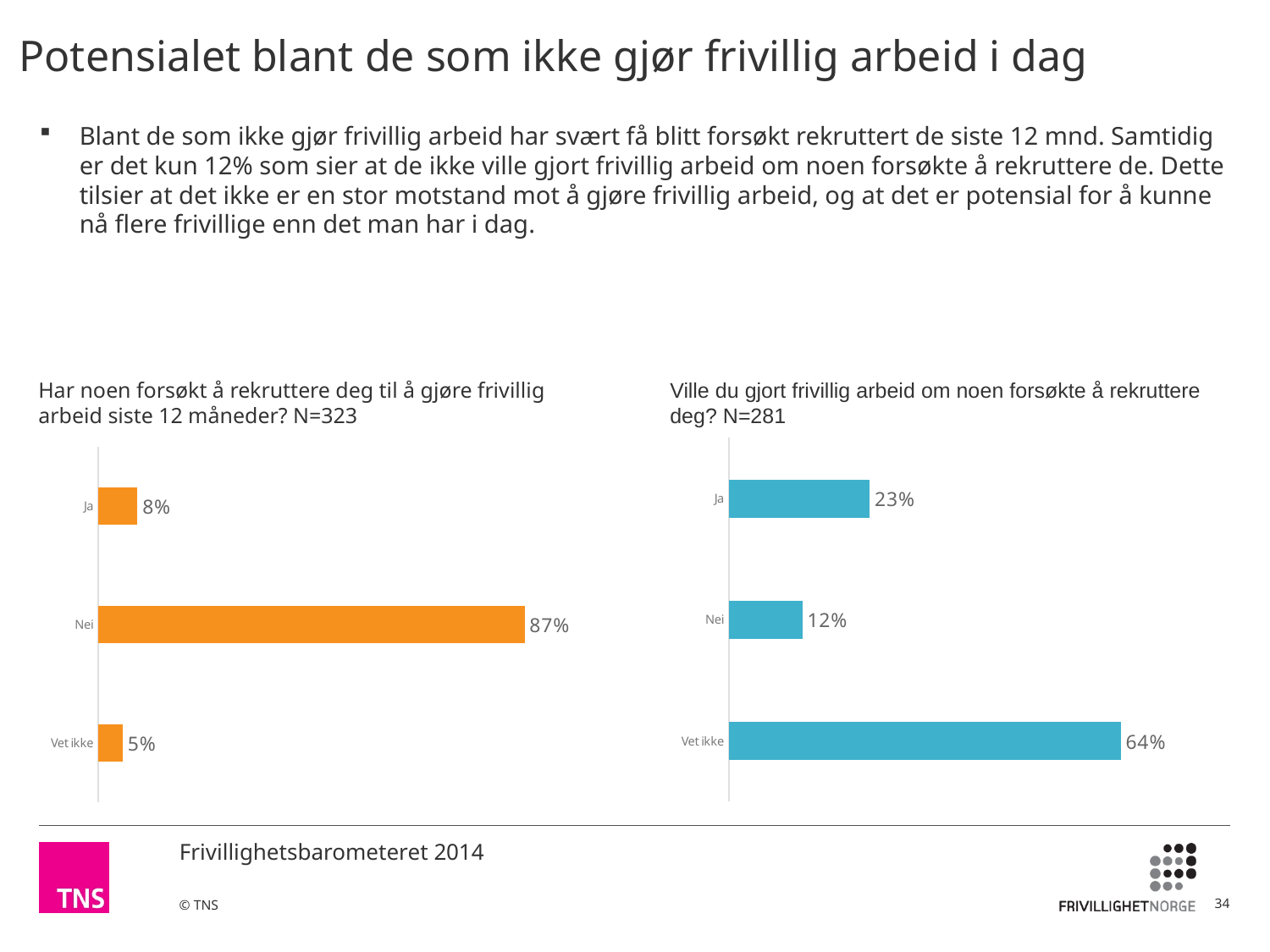
In the left chart (Har noen forsøkt å rekruttere deg...), what is the value for Nei? 87% In the right chart (Ville du gjort frivillig arbeid...), what is the value for Vet ikke? 64% How many categories does the left chart (Har noen forsøkt å rekruttere deg...) show? 3 In the right chart (Ville du gjort frivillig arbeid...), what is the value for Nei? 12% In the left chart (Har noen forsøkt å rekruttere deg...), which category has the highest value? Nei In the left chart (Har noen forsøkt å rekruttere deg...), which category has the lowest value? Vet ikke In the right chart (Ville du gjort frivillig arbeid...), what is the difference between Ja and Nei? 11% In the left chart (Har noen forsøkt å rekruttere deg...), what is the value for Ja? 8% In the right chart (Ville du gjort frivillig arbeid...), which is larger, Ja or Nei? Ja What kind of chart is the right chart (Ville du gjort frivillig arbeid...)? Bar chart In the left chart (Har noen forsøkt å rekruttere deg...), what is the difference between Nei and Ja? 79% In the right chart (Ville du gjort frivillig arbeid...), which category has the highest value? Vet ikke